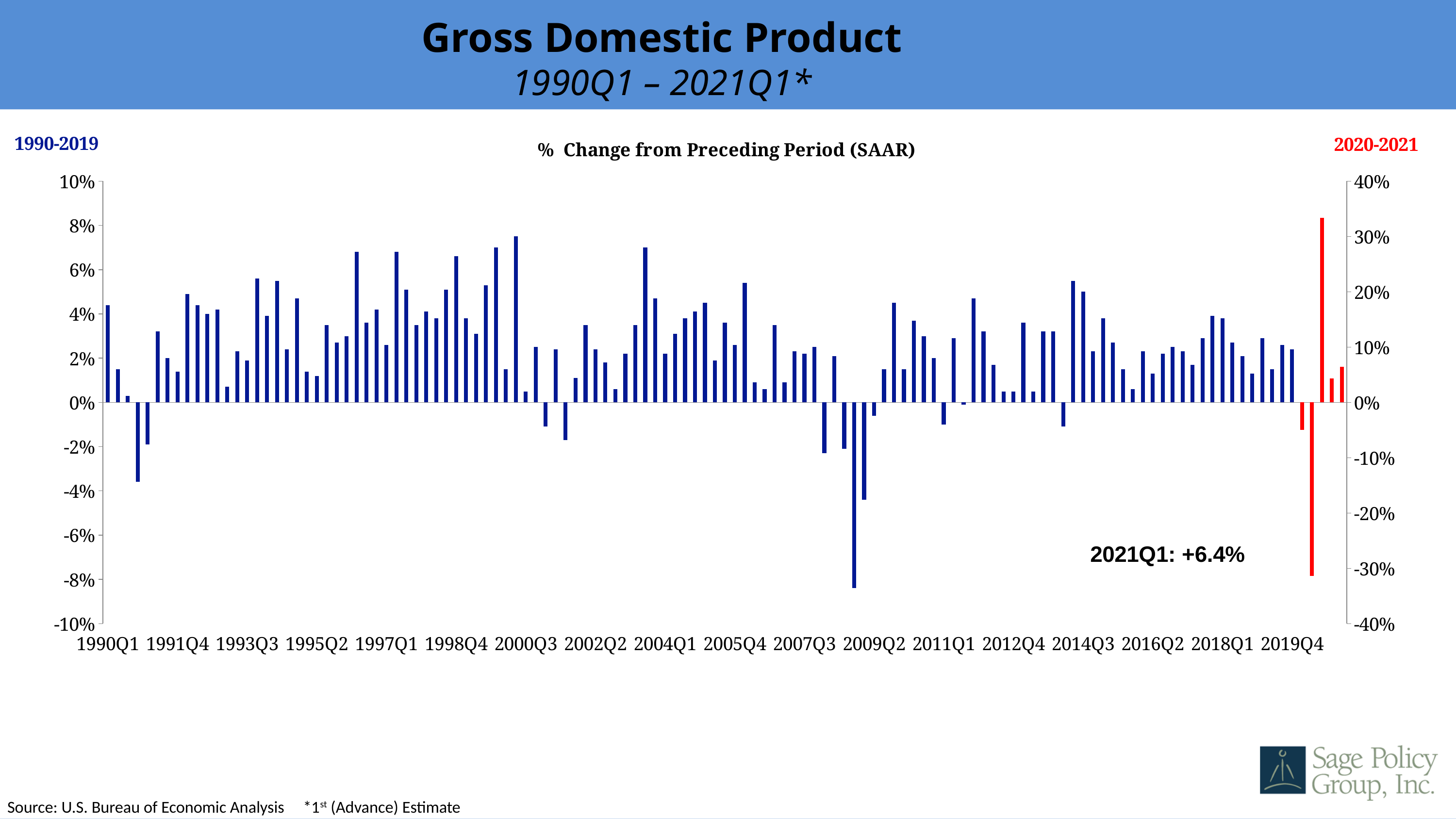
Is the value for 2021Q1 greater or less than 0%? greater What is the maximum value shown on the right vertical axis? 40% Is the lowest red bar (2020) greater or less than -20% on the right axis? less What is the GDP % change value labeled for 2021Q1? +6.4% Is the value for the first bar, 1990Q1, greater or less than 2%? greater What is the maximum value shown on the left vertical axis? 10% What kind of chart is shown on the slide? bar chart What is the title printed above the chart's plot area? % Change from Preceding Period (SAAR) How many series does the chart distinguish (as labeled above the axes)? 2 What colour are the bars for the 2020-2021 period? red